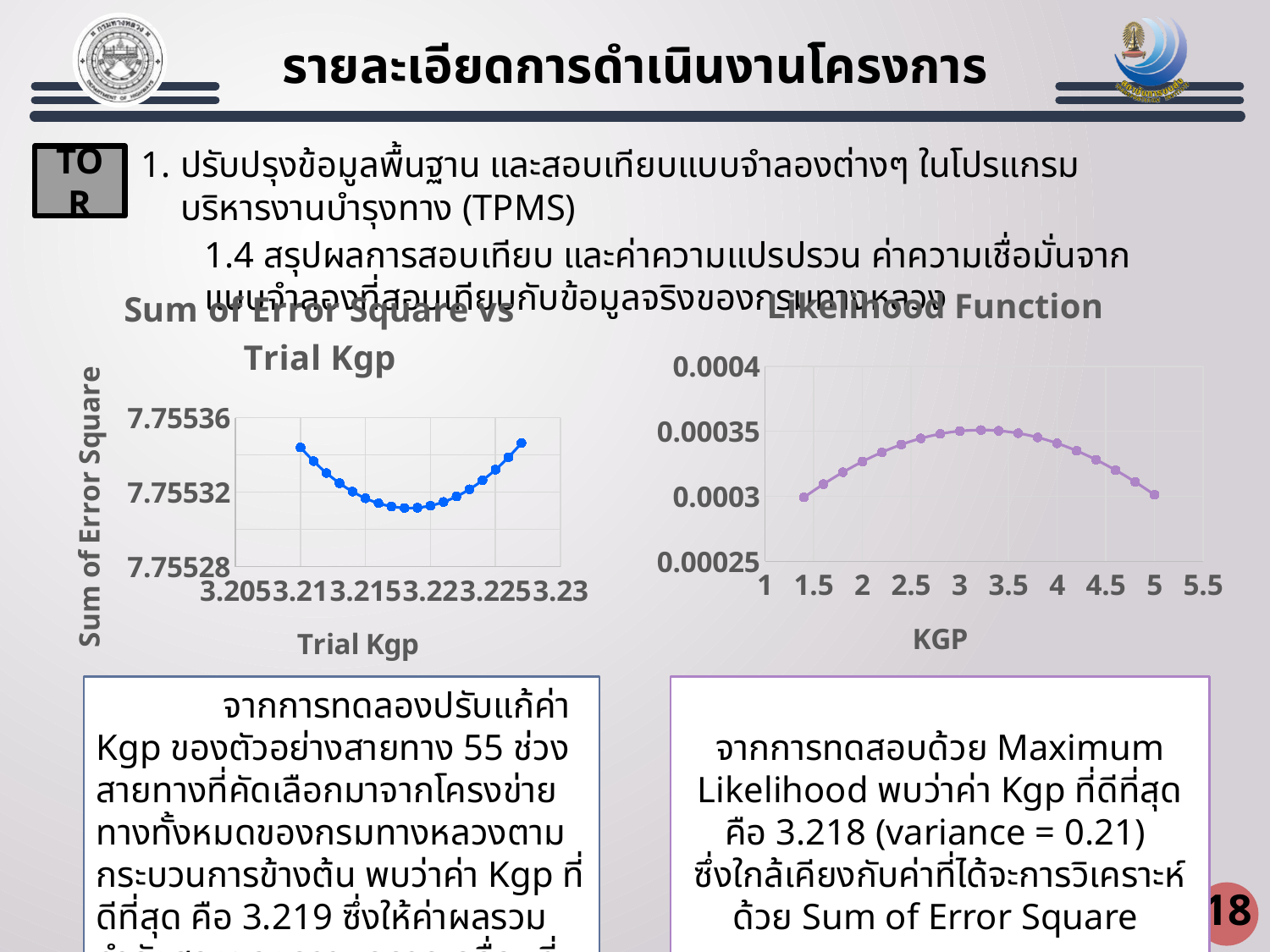
In the 'Likelihood Function' chart, is the value at KGP 1.5 greater or less than 0.00035? less What is the y-axis title of the 'Sum of Error Square vs Trial Kgp' chart? Sum of Error Square In the 'Likelihood Function' chart, is the value at KGP 3.5 greater or less than 0.0003? greater In the 'Sum of Error Square vs Trial Kgp' chart, is the lowest point of the curve greater or less than 7.75532? less In the 'Sum of Error Square vs Trial Kgp' chart, do the values rise or fall as Trial Kgp increases from 3.21 to 3.215? fall In the 'Likelihood Function' chart, which has the larger value: KGP 3 or KGP 5? KGP 3 What is the x-axis title of the 'Likelihood Function' chart? KGP What kind of chart is the 'Likelihood Function' chart? line chart What kind of chart is the 'Sum of Error Square vs Trial Kgp' chart? line chart In the 'Likelihood Function' chart, do the values rise or fall as KGP increases from 1.5 to 3? rise In the 'Likelihood Function' chart, do the values rise or fall as KGP increases from 3.5 to 5? fall